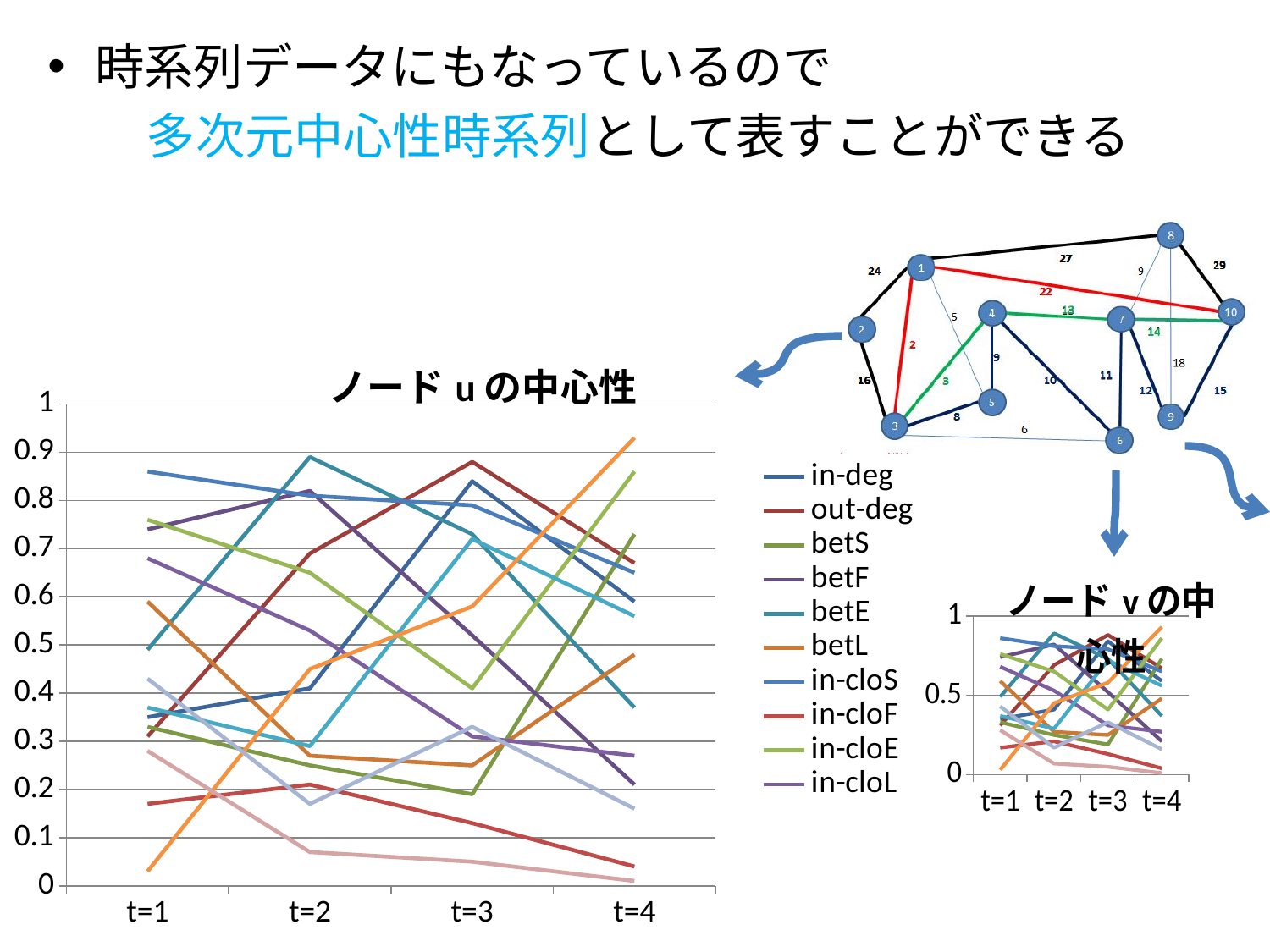
How many time points are shown on the x axis of the "ノード u の中心性" chart? 4 What is the maximum value shown on the y axis of the "ノード u の中心性" chart? 1 What is the title of the large chart on the left? ノード u の中心性 In the "ノード u の中心性" chart, does the betL (orange) line rise or fall from t=1 to t=4? fall What kind of chart is "ノード v の中心性"? line chart In the "ノード u の中心性" chart, is the value of betL (orange) at t=1 greater or less than 0.1? greater In the "ノード u の中心性" chart, is the value of betL (orange) at t=4 greater or less than 0.8? less In the "ノード u の中心性" chart, is the value of in-cloF (red) at t=4 greater or less than 0.1? less In the "ノード u の中心性" chart, which is larger at t=4: betL (orange) or in-cloF (red)? betL What kind of chart is "ノード u の中心性"? line chart What are the x-axis labels of the small "ノード v の中心性" chart? t=1, t=2, t=3, t=4 How many series does the legend between the two charts list? 10